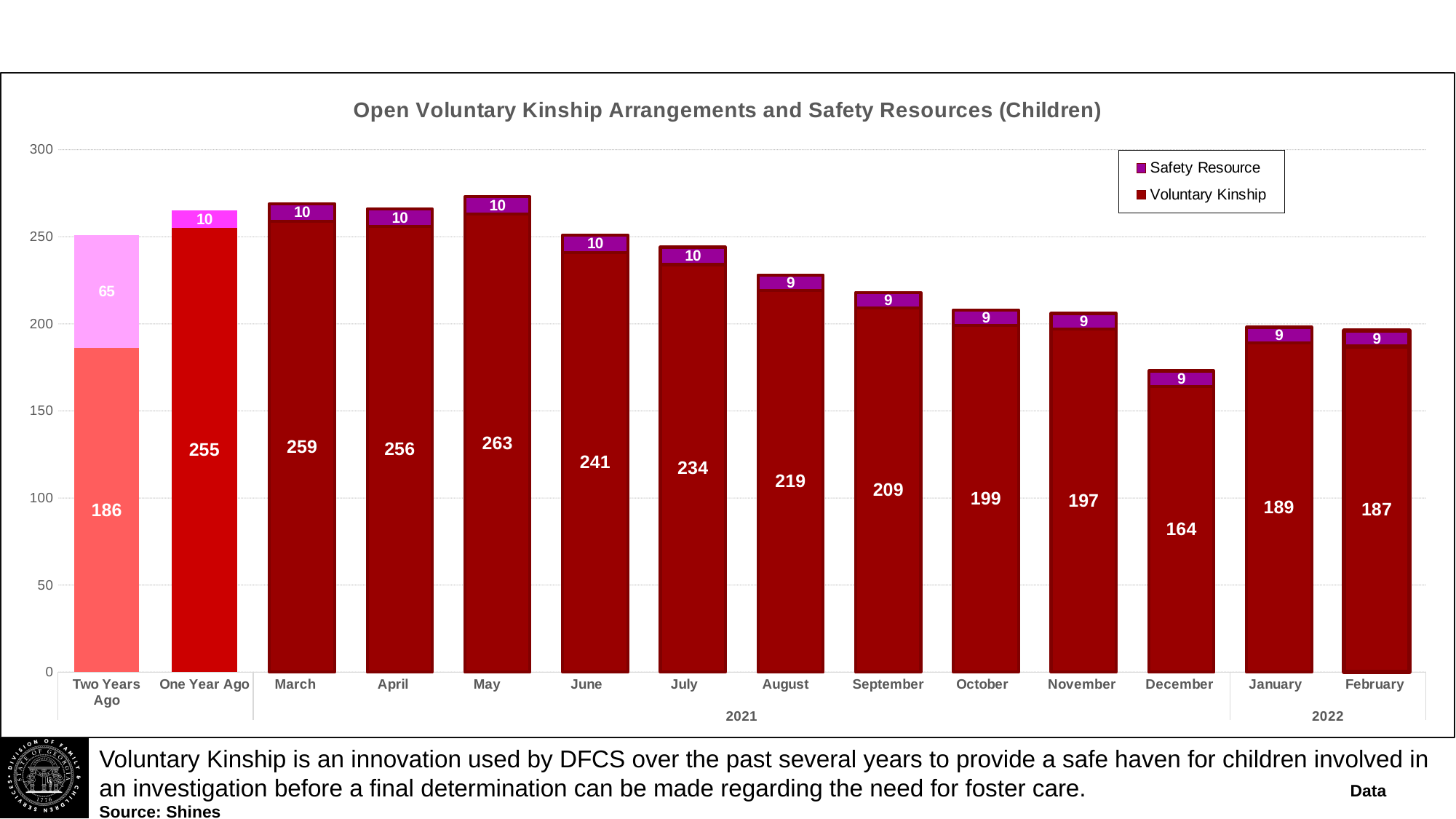
Which category has the lowest Voluntary Kinship value? December What is the Safety Resource value for Two Years Ago? 65 What is the total of the stacked bar for One Year Ago? 265 How many series does the legend list? 2 What is the Voluntary Kinship value for May 2021? 263 Which category has the highest Voluntary Kinship value? May What is the Voluntary Kinship value for December 2021? 164 What kind of chart is shown? Stacked bar chart What is the difference between the Voluntary Kinship values for March and April 2021? 3 What is the total of the stacked bar for December 2021? 173 How many categories are shown on the x axis? 14 Which is larger, the Voluntary Kinship value for January 2022 or February 2022? January 2022